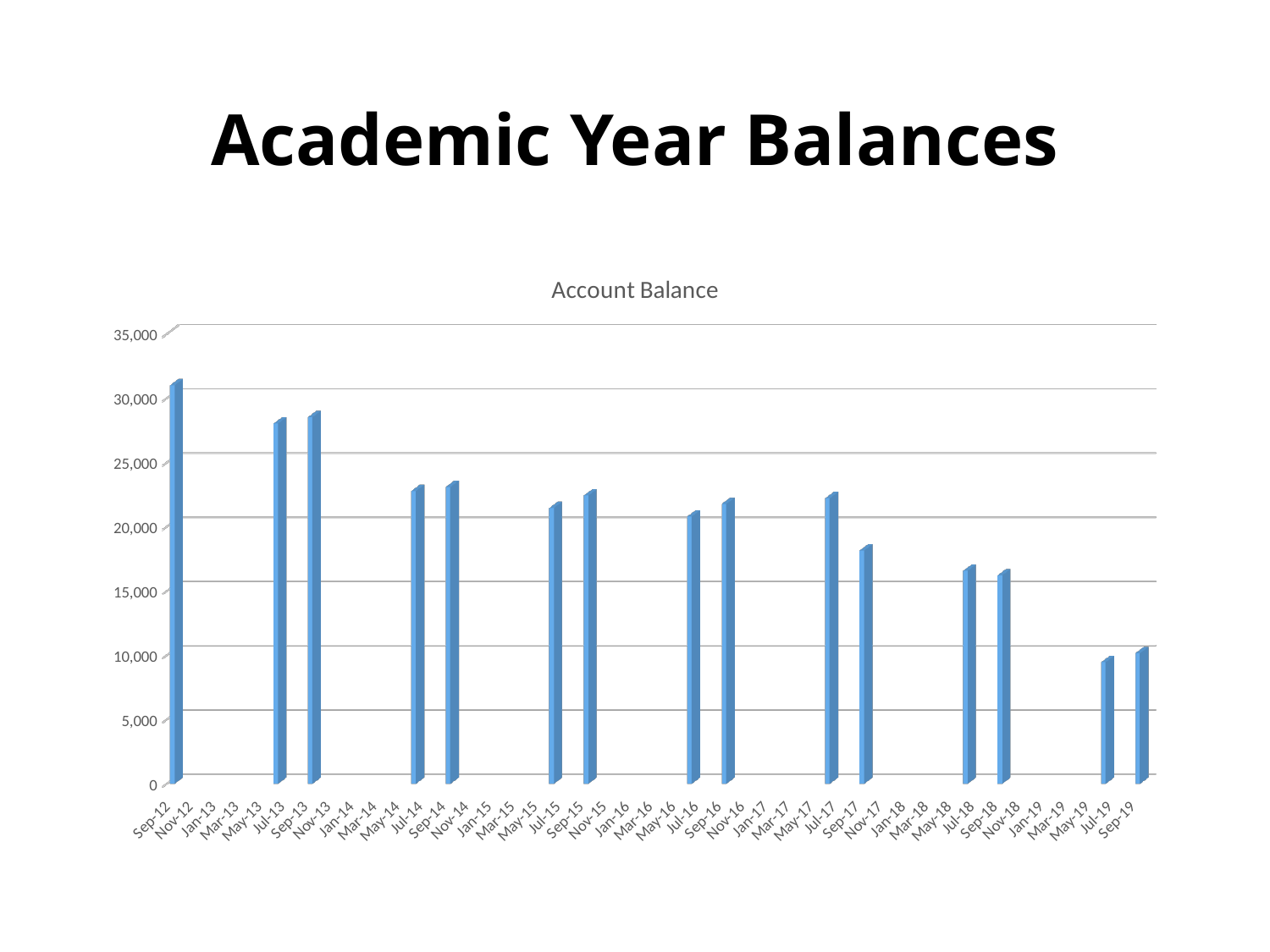
Is the value for Sep-12 greater or less than 30,000? greater Is the value for Sep-17 greater or less than 20,000? less Which is larger, the account balance for Jul-13 or for Jul-18? Jul-13 Which is larger, the account balance for Sep-12 or for Sep-19? Sep-12 What is the title of the chart? Account Balance Is the value for Jul-18 greater or less than 15,000? greater What kind of chart is shown on the slide? bar chart Which month has the lowest account balance? Jul-19 Overall, do the account balances rise or fall from Sep-12 to Sep-19? fall Which month has the highest account balance? Sep-12